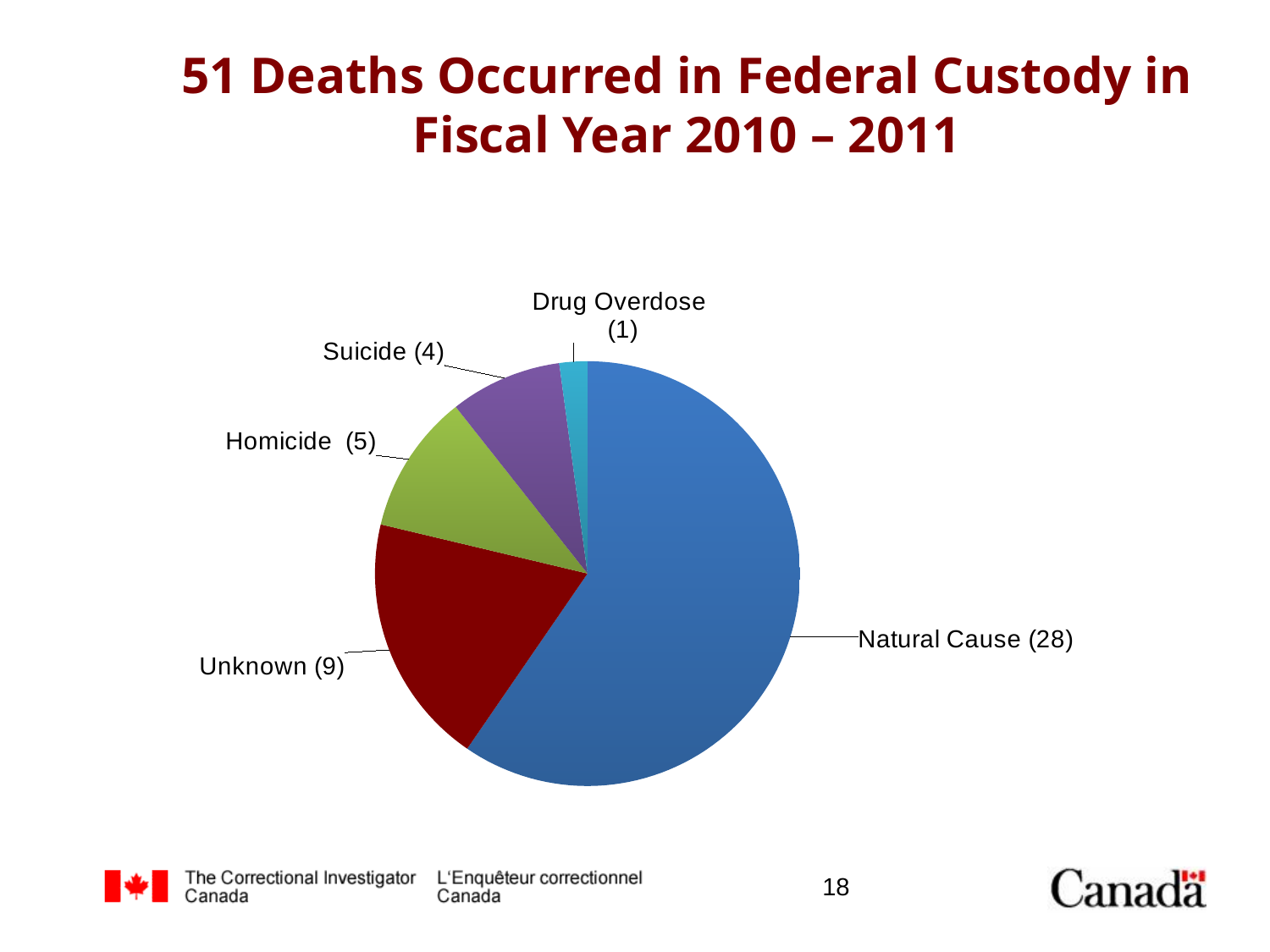
Which cause of death accounts for the smallest slice of the pie? Drug Overdose How many deaths are attributed to Suicide? 4 How many deaths are attributed to Unknown causes? 9 How many deaths are attributed to Natural Cause? 28 What kind of chart is shown on the slide? Pie chart Which is larger, the number of Homicide deaths or the number of Suicide deaths? Homicide Which cause of death accounts for the largest slice of the pie? Natural Cause How many categories (slices) does the pie chart have? 5 How many deaths are attributed to Drug Overdose? 1 How many deaths are attributed to Homicide? 5 What is the total number of deaths shown in the chart title? 51 What is the difference between the number of Natural Cause deaths and Unknown deaths? 19